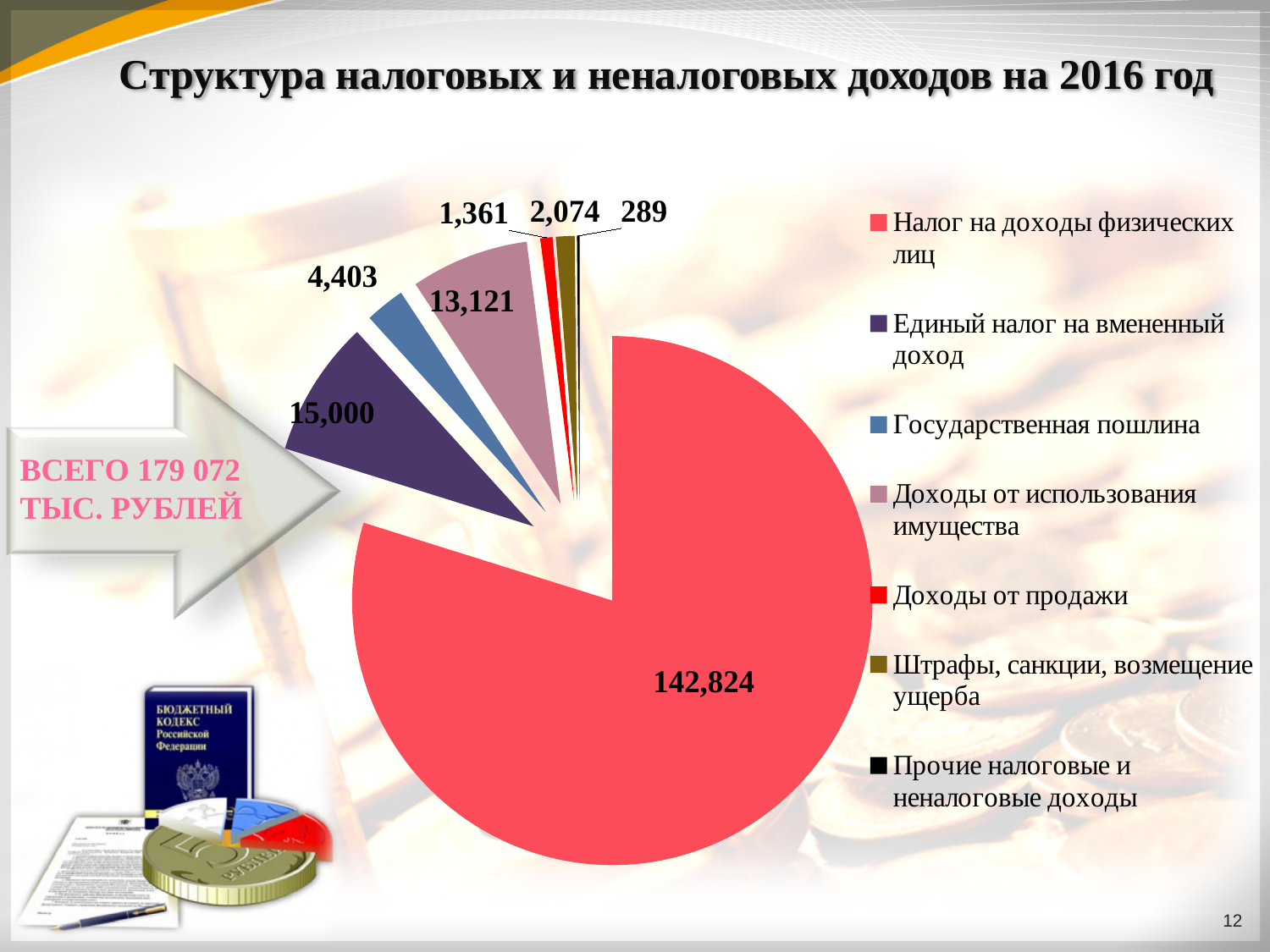
What is the difference between Единый налог на вмененный доход and Доходы от использования имущества? 1,879 What is the value for Государственная пошлина? 4,403 What is the title of the slide? Структура налоговых и неналоговых доходов на 2016 год Which category has the largest slice of the pie? Налог на доходы физических лиц Which is larger: Доходы от продажи or Штрафы, санкции, возмещение ущерба? Штрафы, санкции, возмещение ущерба What is the value for Единый налог на вмененный доход? 15,000 What is the value for Доходы от использования имущества? 13,121 Which category has the smallest slice of the pie? Прочие налоговые и неналоговые доходы What type of chart is shown on the slide? pie chart What is the value for Штрафы, санкции, возмещение ущерба? 2,074 How many slices does the pie chart have? 7 What is the value for Налог на доходы физических лиц? 142,824